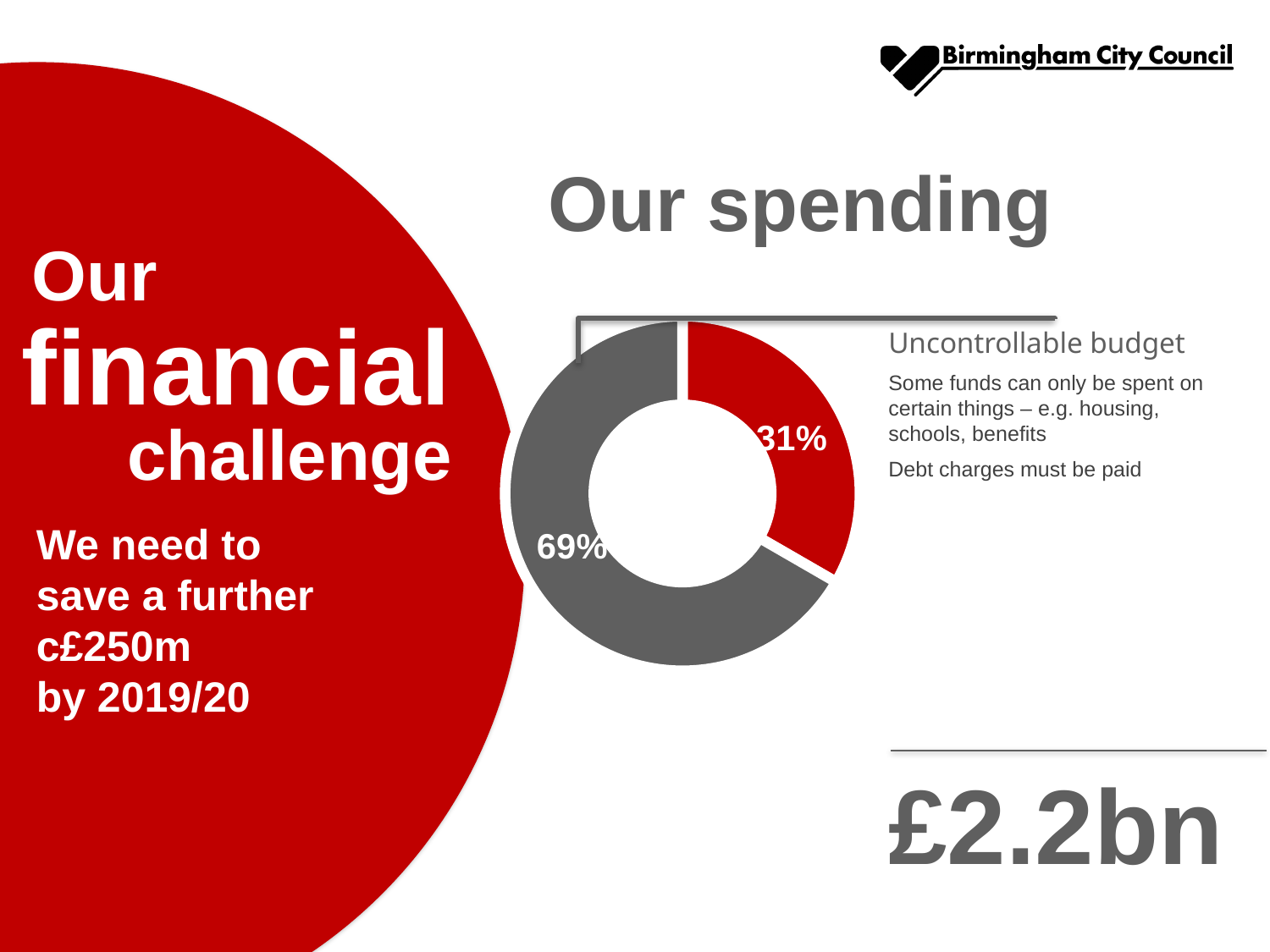
What colour is the slice representing the uncontrollable budget? grey What is the percentage shown on the red slice of the doughnut chart? 31% What is the smallest percentage shown on the doughnut chart? 31% What is the difference in percentage points between the two slices of the doughnut chart? 38 What kind of chart is shown on the slide? doughnut chart What is the largest percentage shown on the doughnut chart? 69% What is the percentage shown on the grey slice of the doughnut chart? 69% What share of the doughnut chart is labelled as the uncontrollable budget? 69% What is the title of the chart on the slide? Our spending Which slice of the doughnut chart is larger, the red slice or the grey slice? the grey slice How many slices does the doughnut chart have? 2 Is the uncontrollable budget share greater or less than 50%? greater